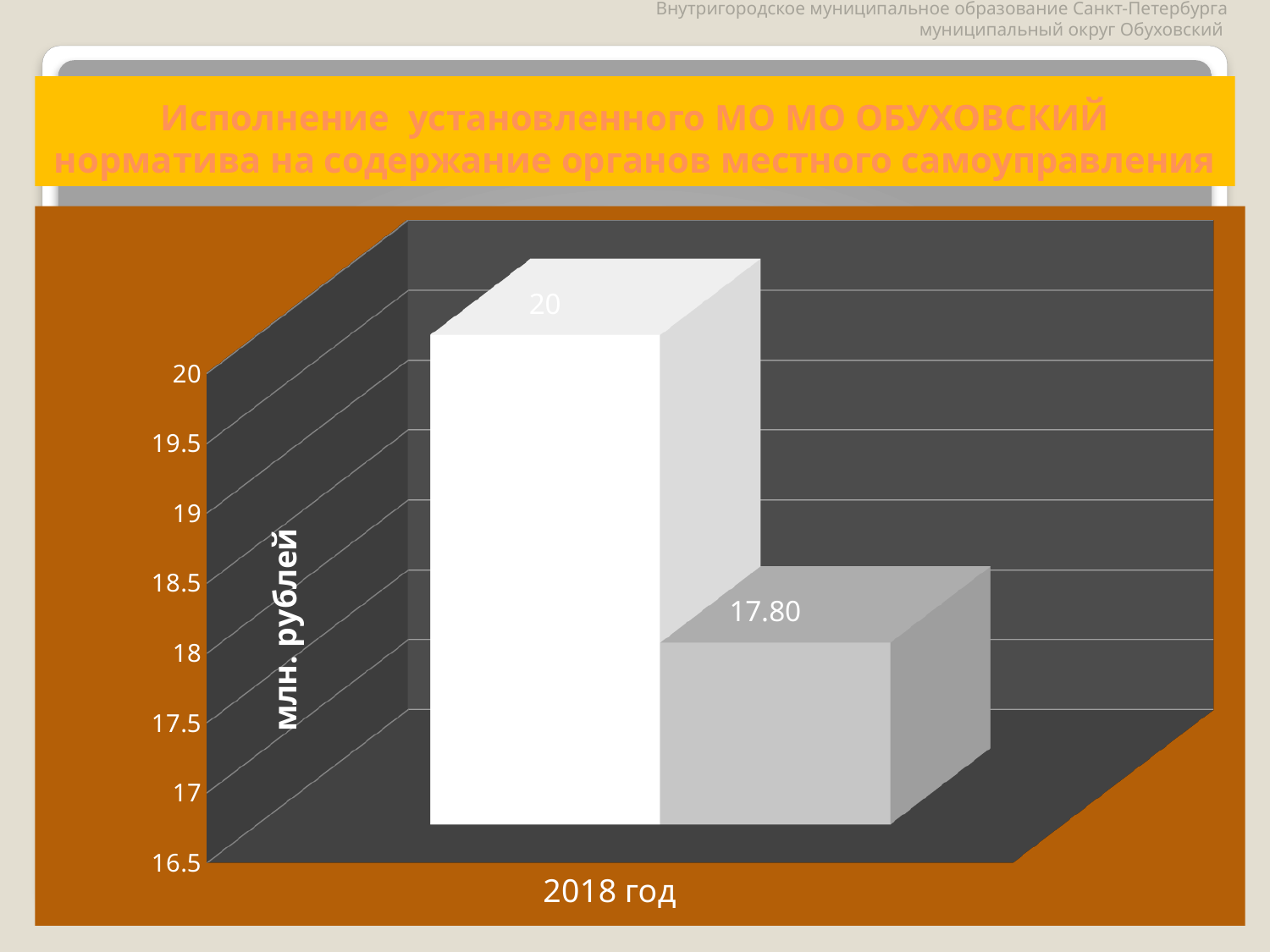
What is the label on the vertical axis of the chart? млн. рублей What kind of chart is shown on the slide? bar chart Which is larger, the value of the white bar or the value of the grey bar? the white bar Which bar is the tallest in the chart? the left (white) bar Which bar is the shortest in the chart? the right (grey) bar What is the category label shown on the x axis? 2018 год Is the value of the white bar greater or less than 19? greater What is the difference between the values of the left bar (20) and the right bar (17.80)? 2.20 What value is printed on the left (white) bar for 2018 год? 20 Is the value of the grey bar greater or less than 18? less What value is printed on the right (grey) bar for 2018 год? 17.80 How many bars are plotted in the chart? 2